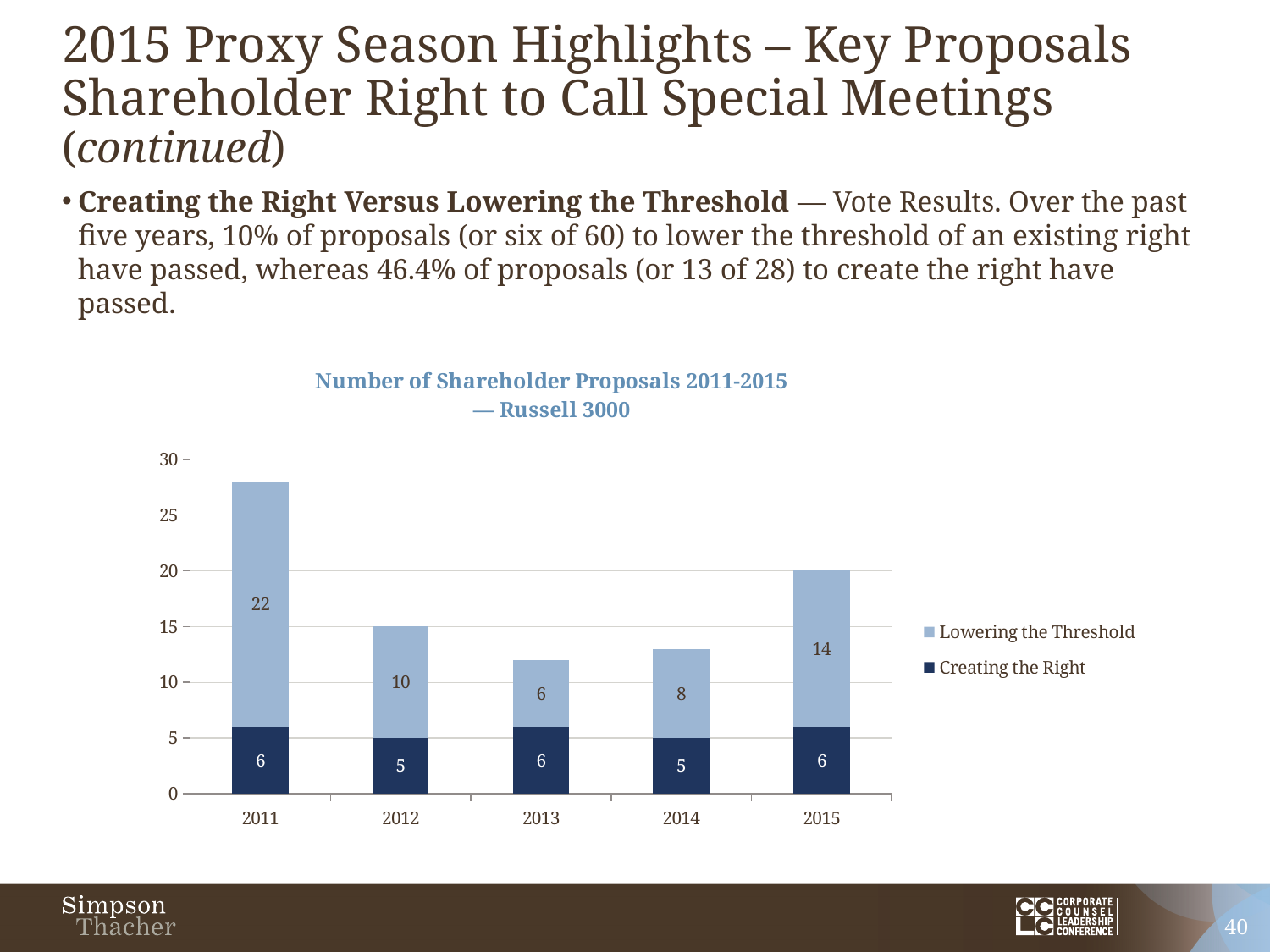
How many years are shown on the x axis? 5 What is the value for Creating the Right in 2014? 5 Which is larger, the Lowering the Threshold value for 2014 or for 2015? 2015 Which year has the highest value for Lowering the Threshold? 2011 What is the total of the stacked bar for 2011? 28 Which year has the lowest value for Lowering the Threshold? 2013 What is the value for Lowering the Threshold in 2015? 14 How many series does the legend list? 2 What kind of chart is shown? Stacked bar chart What is the difference between the Lowering the Threshold values for 2011 and 2012? 12 What is the total of the stacked bar for 2015? 20 What is the value for Lowering the Threshold in 2011? 22